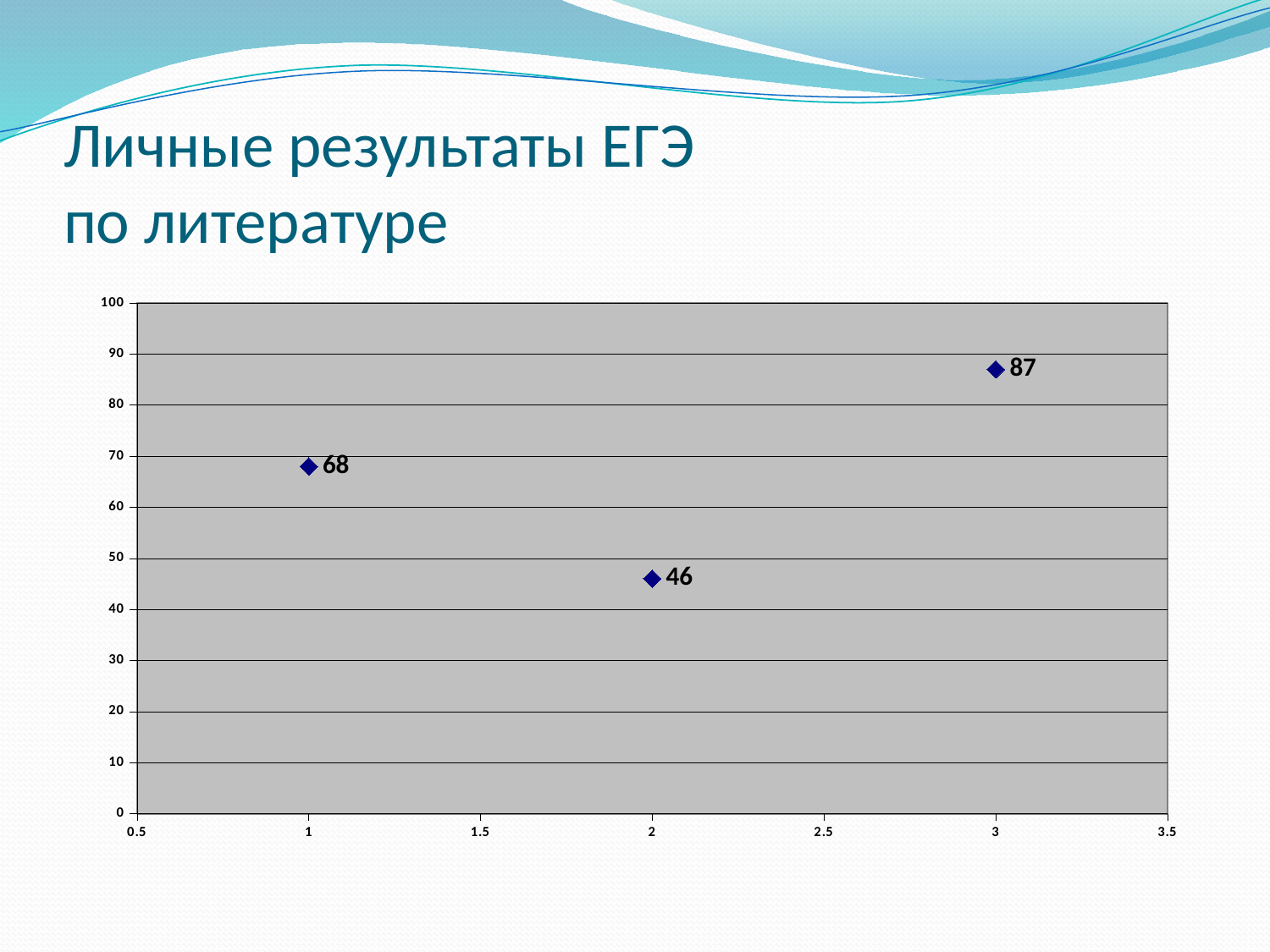
Is the value at x = 3 greater or less than 80? greater What is the difference between the values at x = 3 and x = 1? 19 What is the value of the point at x = 2? 46 How many data points are plotted on the chart? 3 What kind of chart is shown on the slide? scatter chart At which x value is the highest point plotted? 3 What is the value of the point at x = 3? 87 What is the maximum value shown on the vertical axis? 100 At which x value is the lowest point plotted? 2 What is the value of the point at x = 1? 68 What is the difference between the values at x = 1 and x = 2? 22 Which is larger, the value at x = 1 or the value at x = 2? x = 1